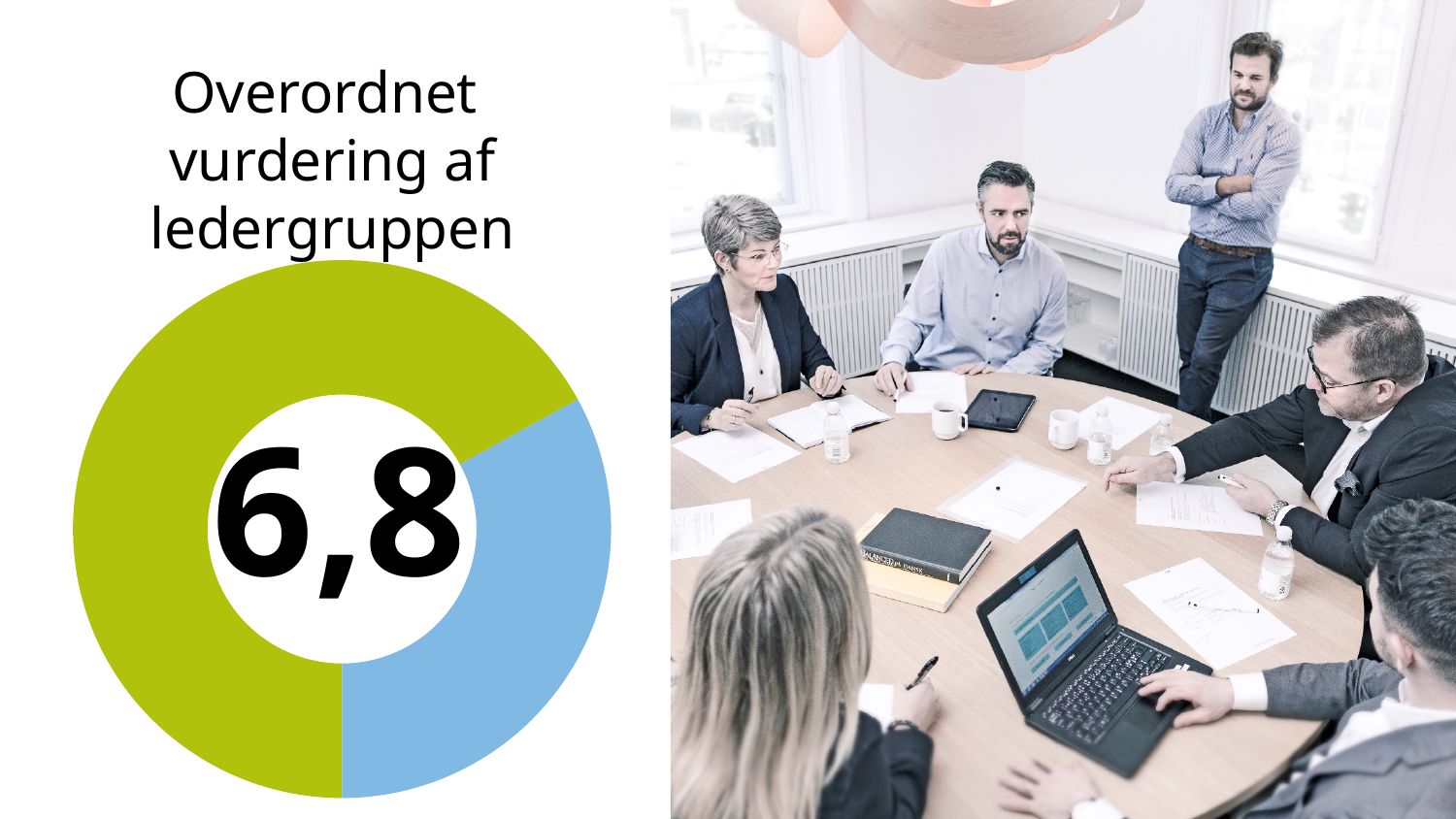
What two colours are used for the slices of the donut chart? Green and blue What kind of chart is shown on the slide? Donut chart What is the title shown above the donut chart? Overordnet vurdering af ledergruppen How many slices does the donut chart have? 2 What value is printed in the centre of the donut chart? 6,8 Which slice of the donut chart is the largest? The green slice Is the blue slice of the donut chart greater or less than half of the ring? less Is the green slice of the donut chart greater or less than half of the ring? greater Which slice of the donut chart is the smallest? The blue slice Which slice of the donut chart is larger, the green one or the blue one? The green one